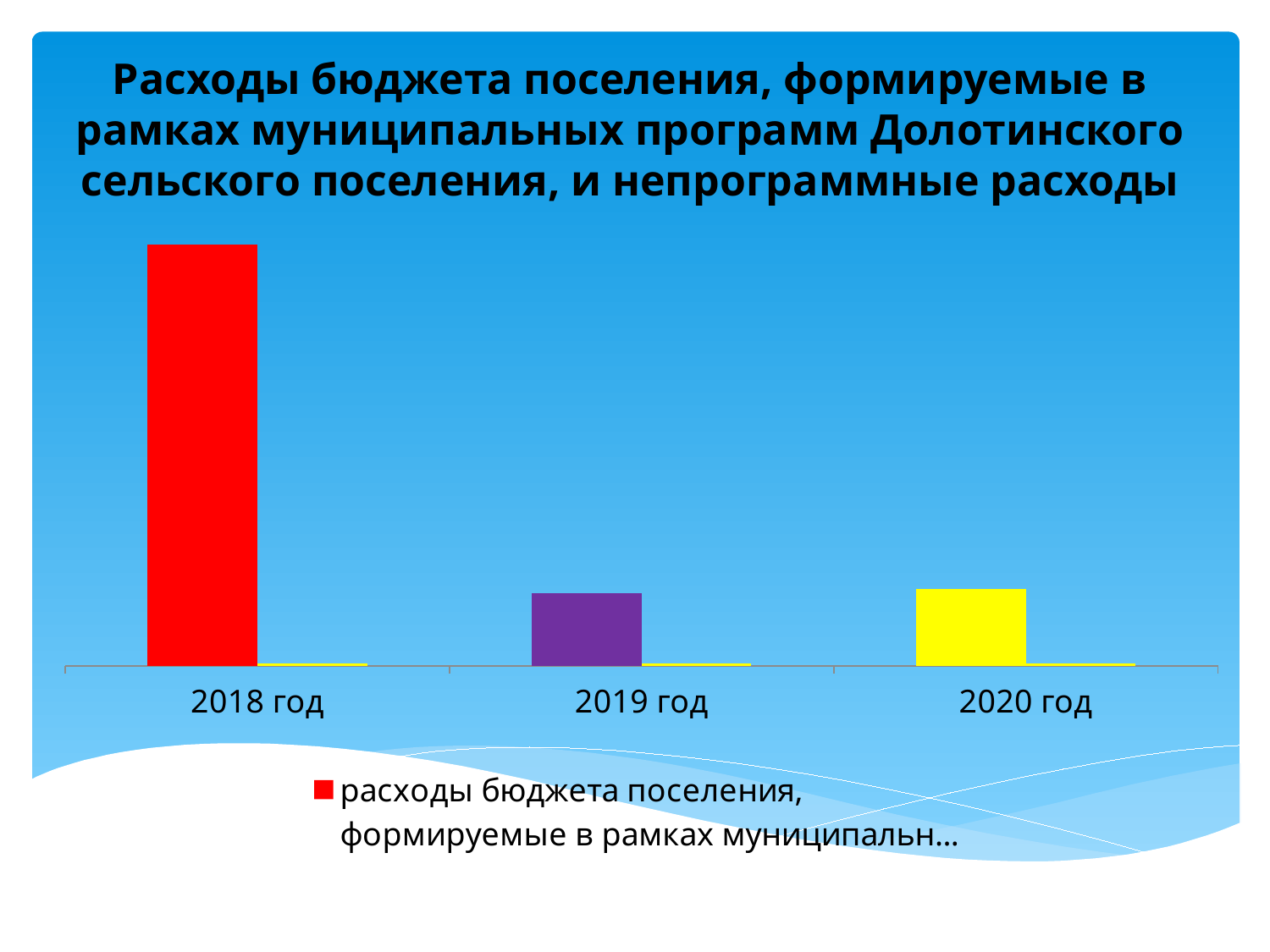
Which is larger, the programme-based expenses bar for 2018 год or for 2020 год? 2018 год Which year has the tallest bar for programme-based budget expenses? 2018 год Does the programme-based expenses bar rise or fall from 2018 год to 2019 год? fall What are the category labels on the x axis of the chart? 2018 год, 2019 год, 2020 год What colour is the bar for 2018 год? red Which is larger, the programme-based expenses bar for 2018 год or for 2019 год? 2018 год How many year categories are shown on the x axis of the chart? 3 What kind of chart is shown on the slide? bar chart